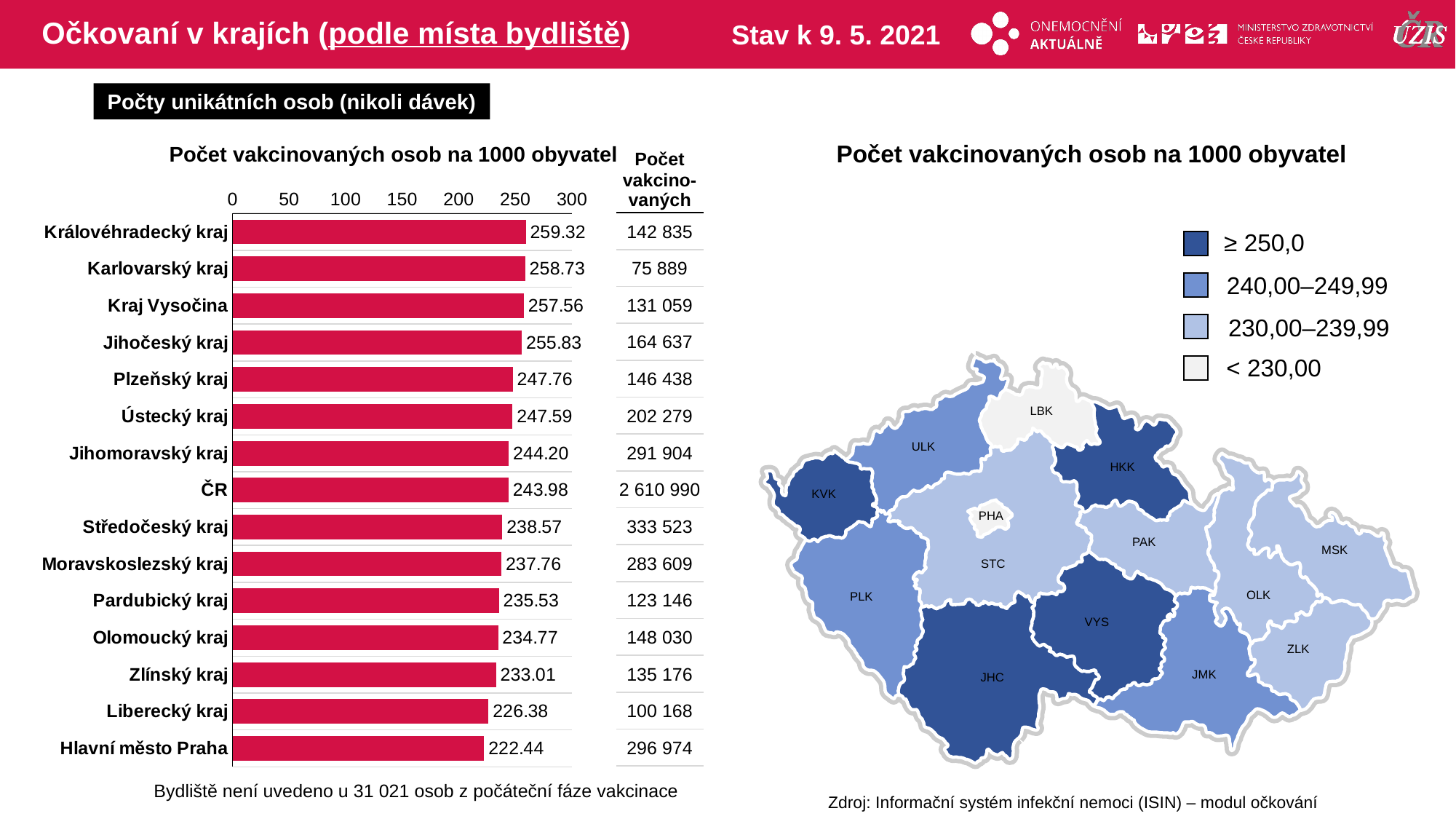
In the bar chart, what is the value for Královéhradecký kraj? 259.32 In the bar chart, which category has the highest value? Královéhradecký kraj In the bar chart, which category has the lowest value? Hlavní město Praha In the bar chart, what is the difference between the values for Královéhradecký kraj and Hlavní město Praha? 36.88 In the bar chart, which has the larger value, Plzeňský kraj or Zlínský kraj? Plzeňský kraj In the bar chart, what is the value for Hlavní město Praha? 222.44 How many bars does the bar chart show? 15 In the bar chart, do the values rise or fall going from the top bar to the bottom bar? fall In the bar chart, is the value for Liberecký kraj greater or less than 250? less What kind of chart is shown on the left of the slide? bar chart How many colour categories does the legend of the map on the right list? 4 In the bar chart, what is the value for ČR? 243.98